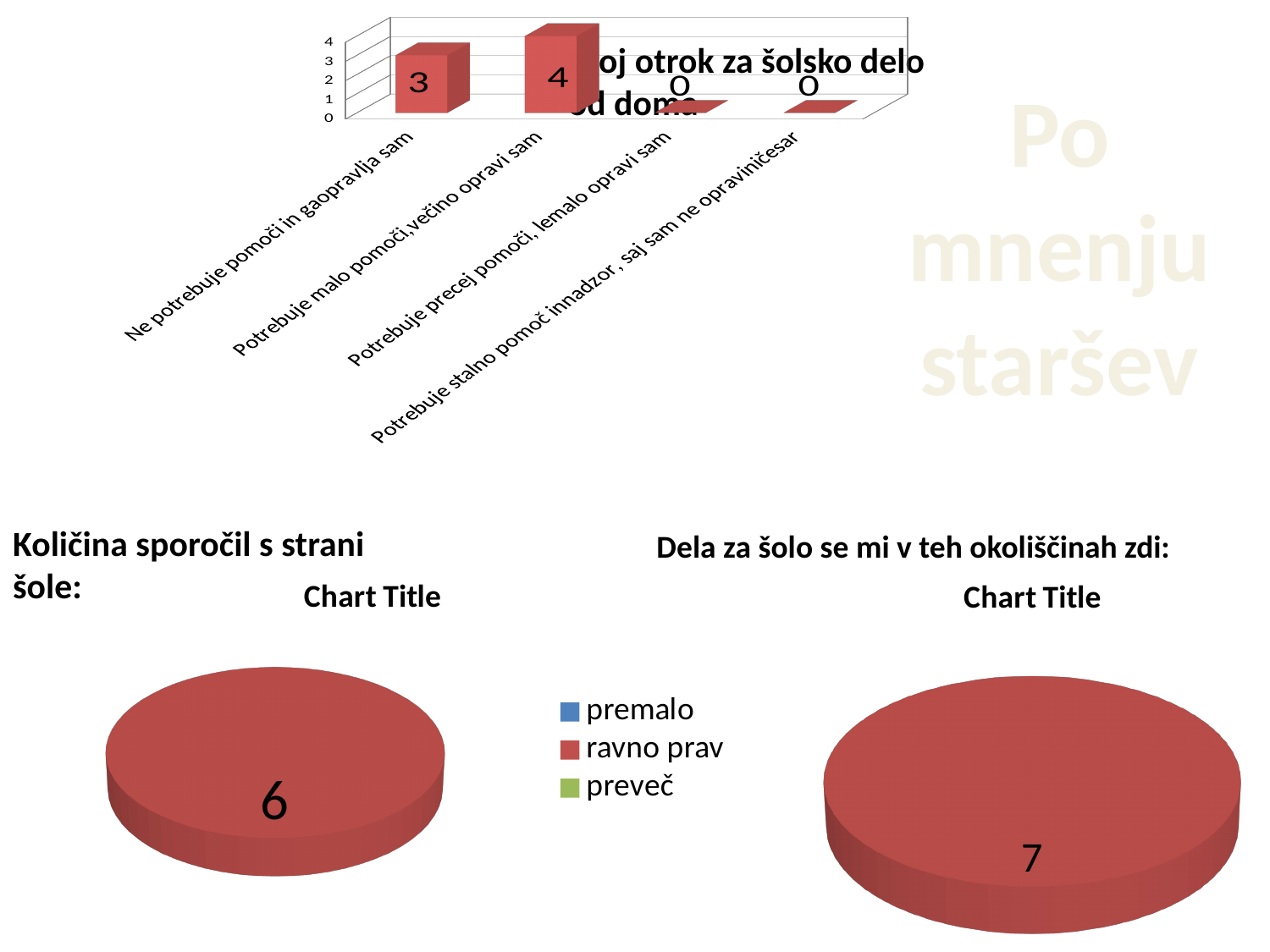
In the top bar chart, what is the difference between the values for 'Potrebuje malo pomoči, večino opravi sam' and 'Ne potrebuje pomoči in ga opravlja sam'? 1 How many entries does the legend next to the bottom-left pie chart list? 3 In the top bar chart, what is the value for 'Potrebuje precej pomoči, le malo opravi sam'? 0 In the top bar chart, which is larger: the value for 'Ne potrebuje pomoči in ga opravlja sam' or the value for 'Potrebuje stalno pomoč in nadzor, saj sam ne opravi ničesar'? Ne potrebuje pomoči in ga opravlja sam What kind of chart is the chart at the top of the slide? bar chart In the top bar chart, what is the value for 'Ne potrebuje pomoči in ga opravlja sam'? 3 What kind of chart is shown at the bottom right of the slide? pie chart In the top bar chart, how many categories are shown on the x axis? 4 In the pie chart under 'Količina sporočil s strani šole', what value is printed on the slice? 6 In the pie chart under 'Dela za šolo se mi v teh okoliščinah zdi', what value is printed on the slice? 7 In the top bar chart, what is the value for 'Potrebuje malo pomoči, večino opravi sam'? 4 In the top bar chart, which category has the highest value? Potrebuje malo pomoči, večino opravi sam